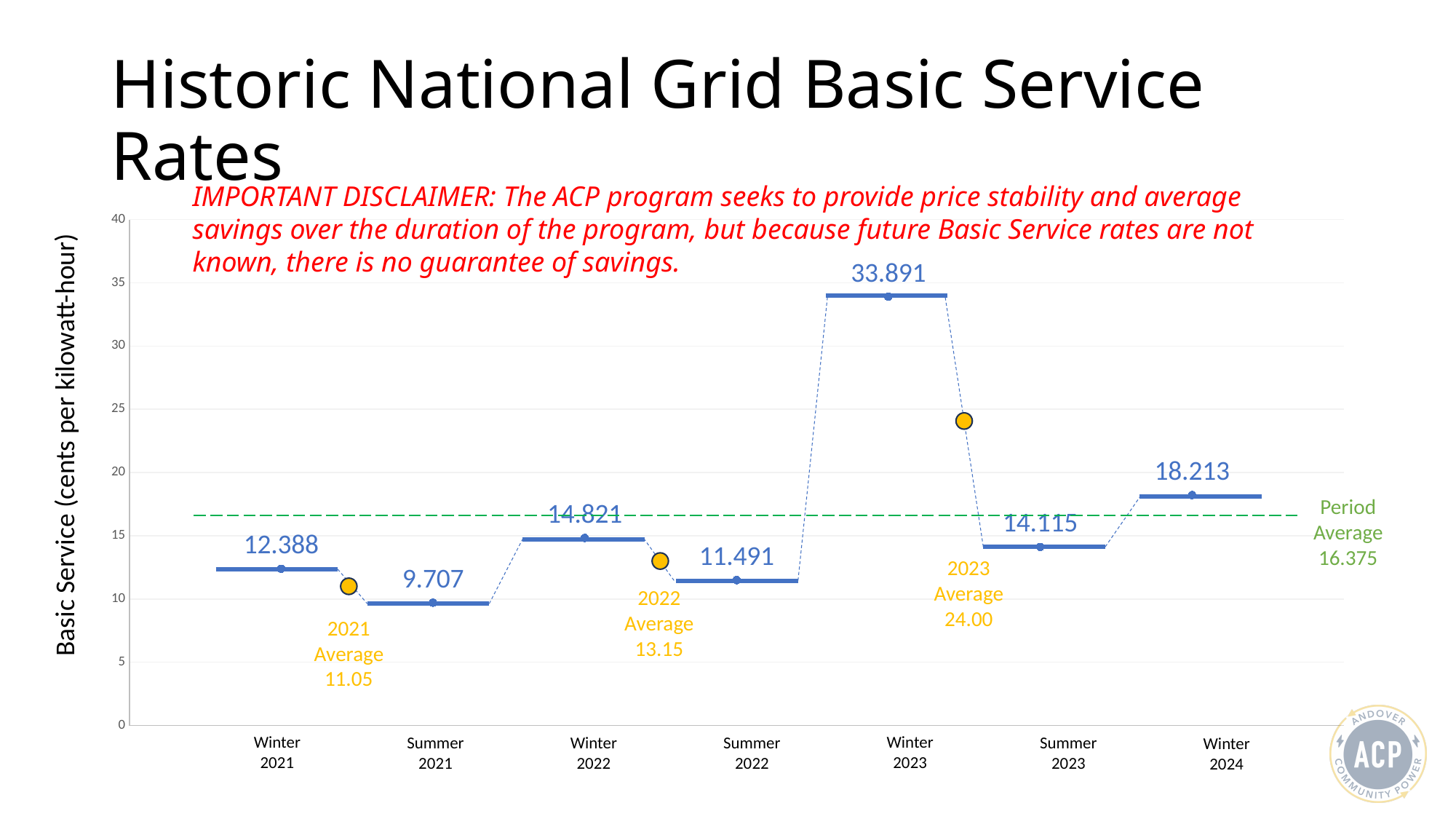
What is the Basic Service rate for Winter 2024? 18.213 What kind of chart is shown on the slide? Line chart Which is larger, the Winter 2022 rate or the Summer 2022 rate? Winter 2022 Which period has the highest Basic Service rate? Winter 2023 What is the Basic Service rate for Winter 2023? 33.891 What is the label of the y axis? Basic Service (cents per kilowatt-hour) What is the difference between the Winter 2023 rate and the Summer 2023 rate? 19.776 What is the 2022 Average shown on the chart? 13.15 Which period has the lowest Basic Service rate? Summer 2021 What is the Basic Service rate for Summer 2021? 9.707 How many periods are plotted on the x axis? 7 What is the Period Average shown on the chart? 16.375